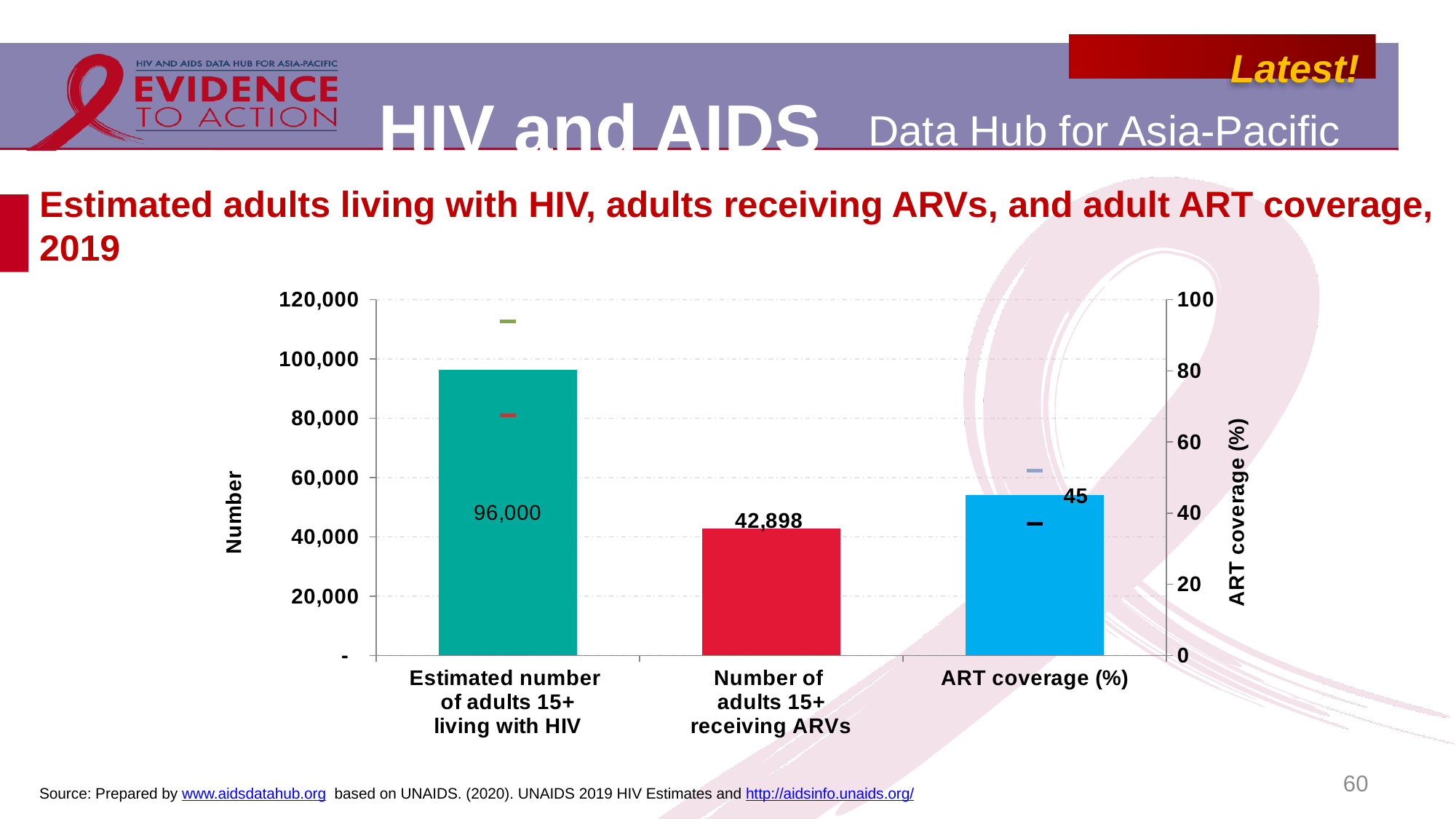
Which is larger: the estimated number of adults 15+ living with HIV or the number of adults 15+ receiving ARVs? Estimated number of adults 15+ living with HIV What is the number of adults 15+ receiving ARVs shown on the chart? 42,898 What is the estimated number of adults 15+ living with HIV shown on the chart? 96,000 What is the ART coverage (%) value shown on the chart? 45 What is the title of the left vertical axis of the chart? Number What kind of chart is shown on the slide? Bar chart Is the estimated number of adults 15+ living with HIV greater or less than 80,000? greater How many bars are plotted on the chart? 3 What is the maximum value shown on the right vertical axis of the chart? 100 What is the title of the right vertical axis of the chart? ART coverage (%) Is the number of adults 15+ receiving ARVs greater or less than 60,000? less What is the difference between the estimated number of adults 15+ living with HIV and the number of adults 15+ receiving ARVs? 53,102